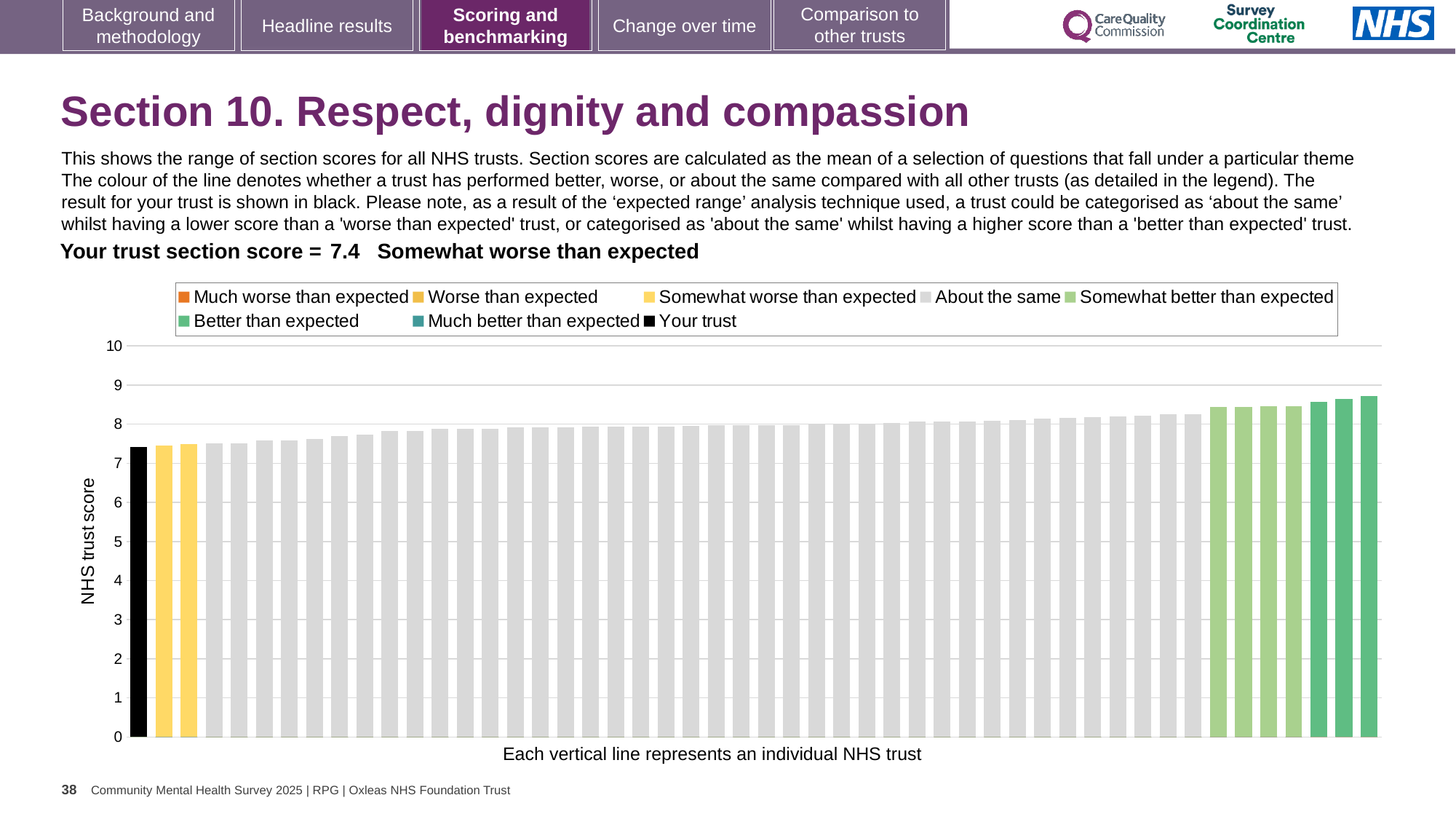
What is the label on the vertical axis of the chart? NHS trust score Do the bar values rise or fall from left to right along the x axis? rise Is the value for the black 'Your trust' bar greater or less than 8? less What kind of chart is shown on the slide? bar chart What is the section score for your trust shown on the slide? 7.4 Is the value of the tallest bar on the right of the chart greater or less than 8? greater How many yellow 'Somewhat worse than expected' bars are shown (excluding the black 'Your trust' bar)? 2 How many entries does the chart legend list? 8 Which category does the slide say your trust falls into for this section? Somewhat worse than expected Is the value of the leftmost bar greater or less than 5? greater